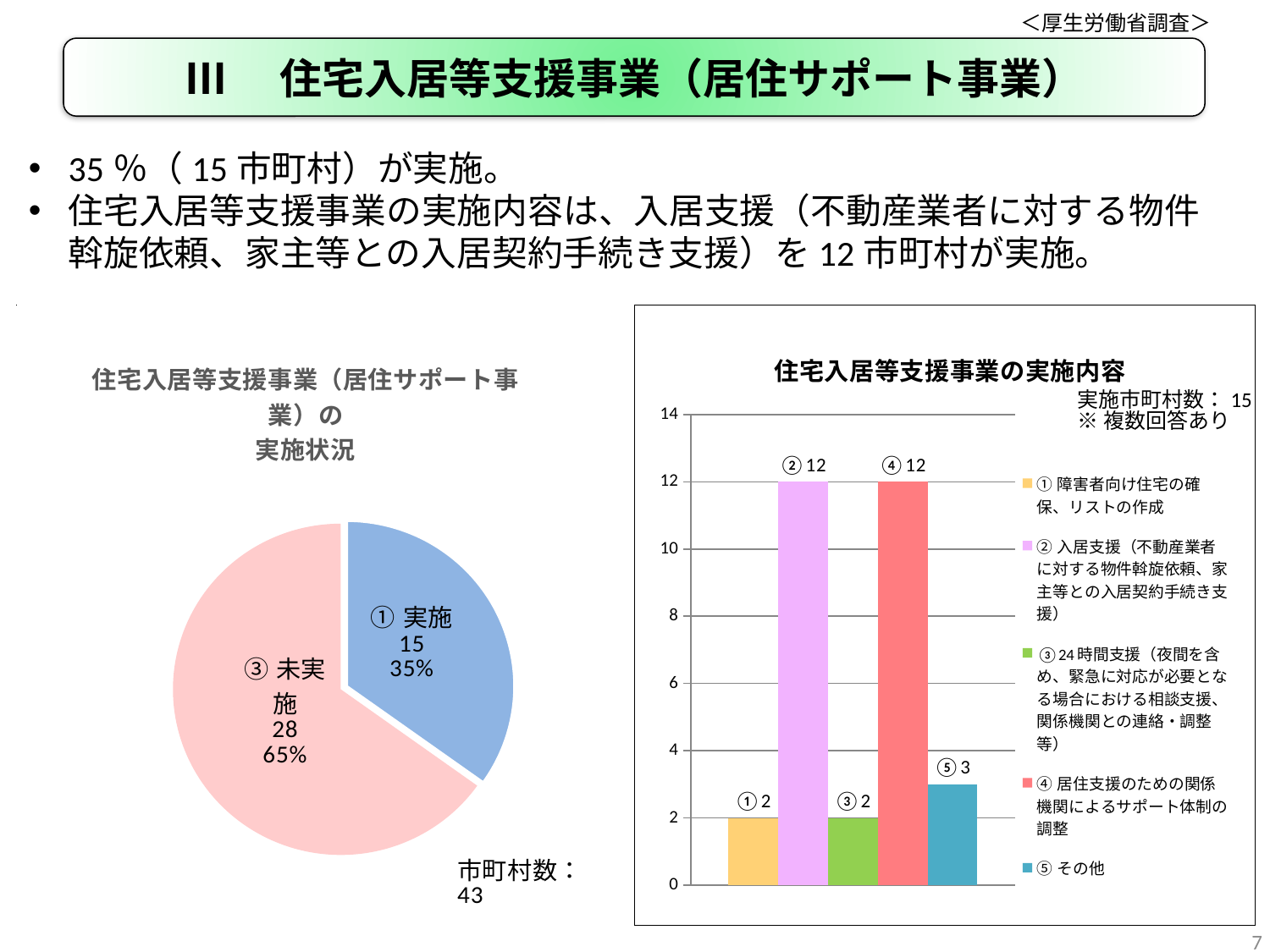
In the pie chart on the left, what is the value shown for ① 実施? 15 In the bar chart titled 住宅入居等支援事業の実施内容, what is the value for ⑤ その他? 3 What kind of chart is the chart on the left of the slide? Pie chart In the pie chart on the left, what percentage share does ③ 未実施 have? 65% What kind of chart is the chart on the right of the slide? Bar chart In the pie chart on the left, what is the difference between the values for ③ 未実施 and ① 実施? 13 In the bar chart titled 住宅入居等支援事業の実施内容, how many bars are plotted? 5 In the bar chart titled 住宅入居等支援事業の実施内容, is the value for ② greater or less than 10? greater In the bar chart titled 住宅入居等支援事業の実施内容, what is the difference between the values for ④ and ⑤? 9 In the bar chart titled 住宅入居等支援事業の実施内容, which category has the lowest value? ① and ③ (both 2) In the pie chart on the left, which slice is larger, ① 実施 or ③ 未実施? ③ 未実施 In the bar chart titled 住宅入居等支援事業の実施内容, what is the value for ② 入居支援? 12